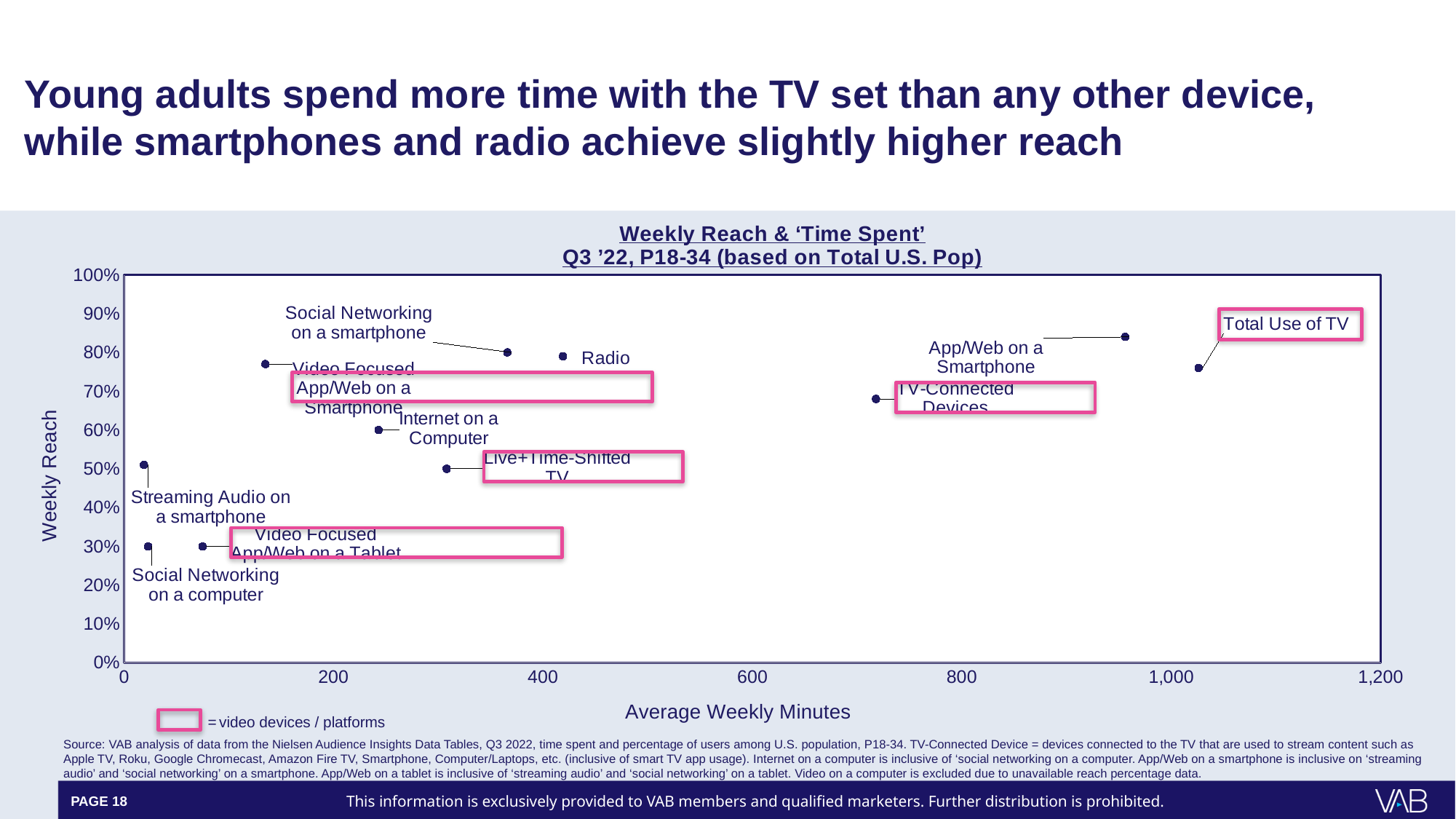
Which device/platform has the highest Average Weekly Minutes? Total Use of TV How many data points are plotted on the chart? 11 Which has a higher Weekly Reach, App/Web on a Smartphone or TV-Connected Devices? App/Web on a Smartphone According to the legend, what do the pink boxes around labels indicate? video devices / platforms Which has more Average Weekly Minutes, Radio or Internet on a Computer? Radio What kind of chart is shown on the slide? Scatter chart Is the Weekly Reach for Live+Time-Shifted TV greater or less than 60%? less Which device/platform has the highest Weekly Reach? App/Web on a Smartphone Is the Weekly Reach for TV-Connected Devices greater or less than 60%? greater Is the Average Weekly Minutes value for Streaming Audio on a smartphone greater or less than 200? less What is the title of the x axis? Average Weekly Minutes